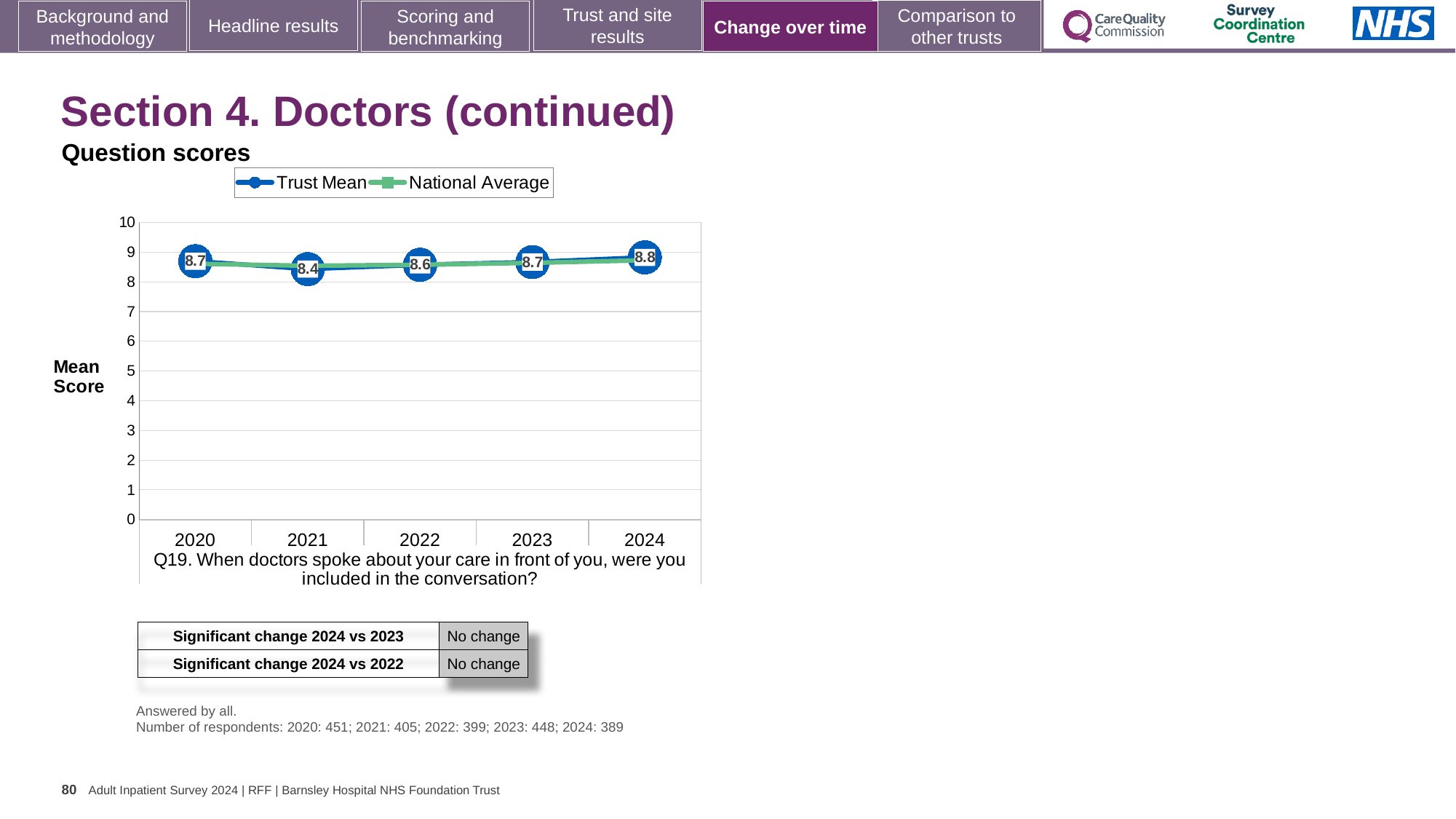
In which year is the Trust Mean score highest? 2024 Is the National Average value for 2021 greater or less than 8? greater How many series does the legend list? 2 What kind of chart is shown? Line chart How many years are plotted on the x axis? 5 What is the difference between the Trust Mean scores for 2024 and 2021? 0.4 What is the Trust Mean score for 2020? 8.7 What is the Trust Mean score for 2024? 8.8 What is the Trust Mean score for 2021? 8.4 Does the Trust Mean score rise or fall from 2021 to 2024? Rise Is the Trust Mean score for 2022 larger than the Trust Mean score for 2023? No In which year is the Trust Mean score lowest? 2021